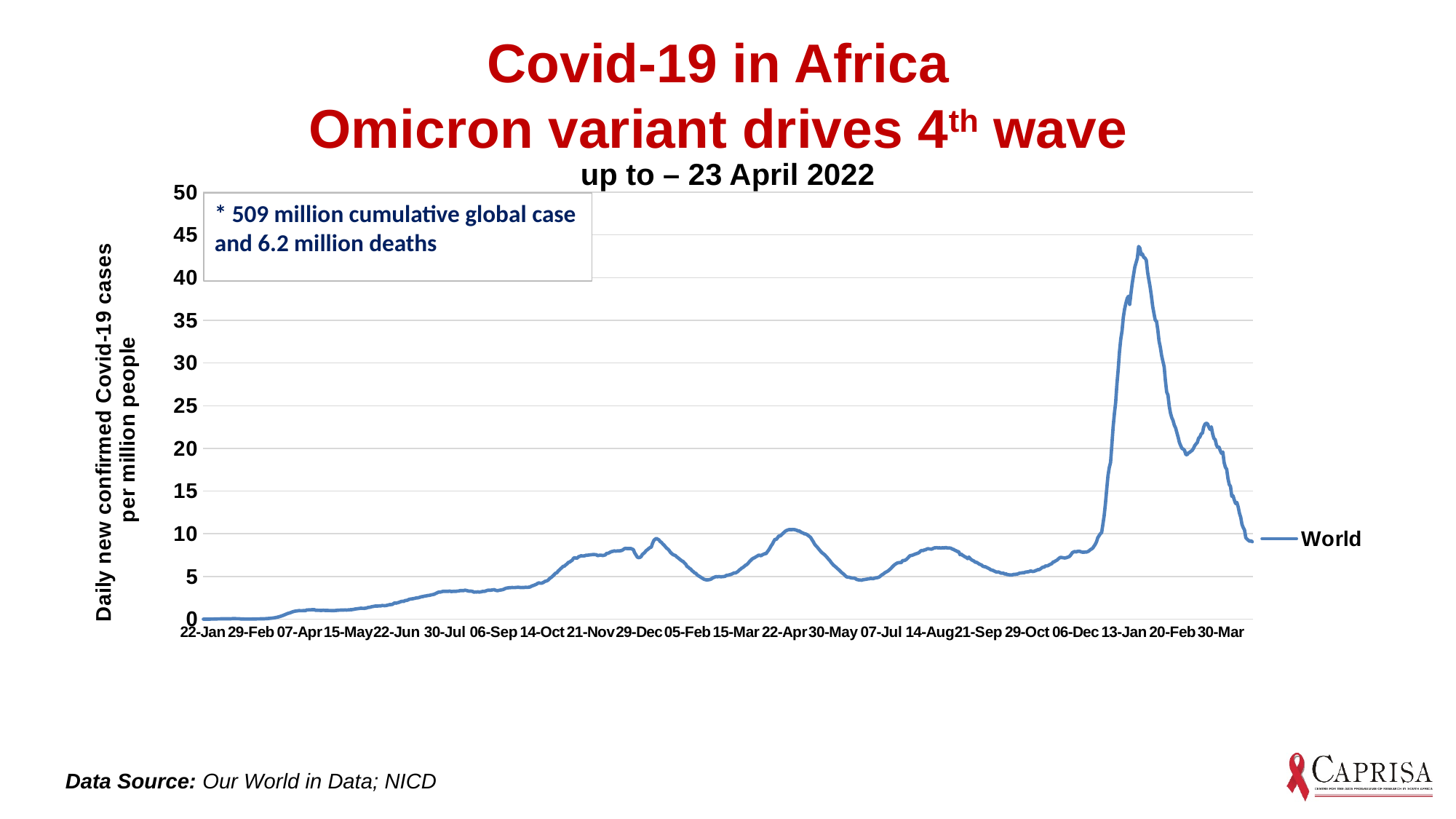
What is the name of the series shown in the chart's legend? World Is the value for World at 22-Jan (the start of the chart) greater or less than 5? less What is the highest value shown on the chart's vertical axis? 50 What kind of chart is shown on the slide? Line chart Does the World line rise or fall between 22-Jan and 15-May at the start of the chart? Rise Is the peak value of the World line greater or less than 40? greater How many series does the chart's legend list? 1 Is the value for World at 06-Sep greater or less than 5? less What is the label on the chart's vertical axis? Daily new confirmed Covid-19 cases per million people Does the World line rise or fall between 13-Jan and 20-Feb? Fall Around which x-axis date does the World line reach its highest value? 13-Jan